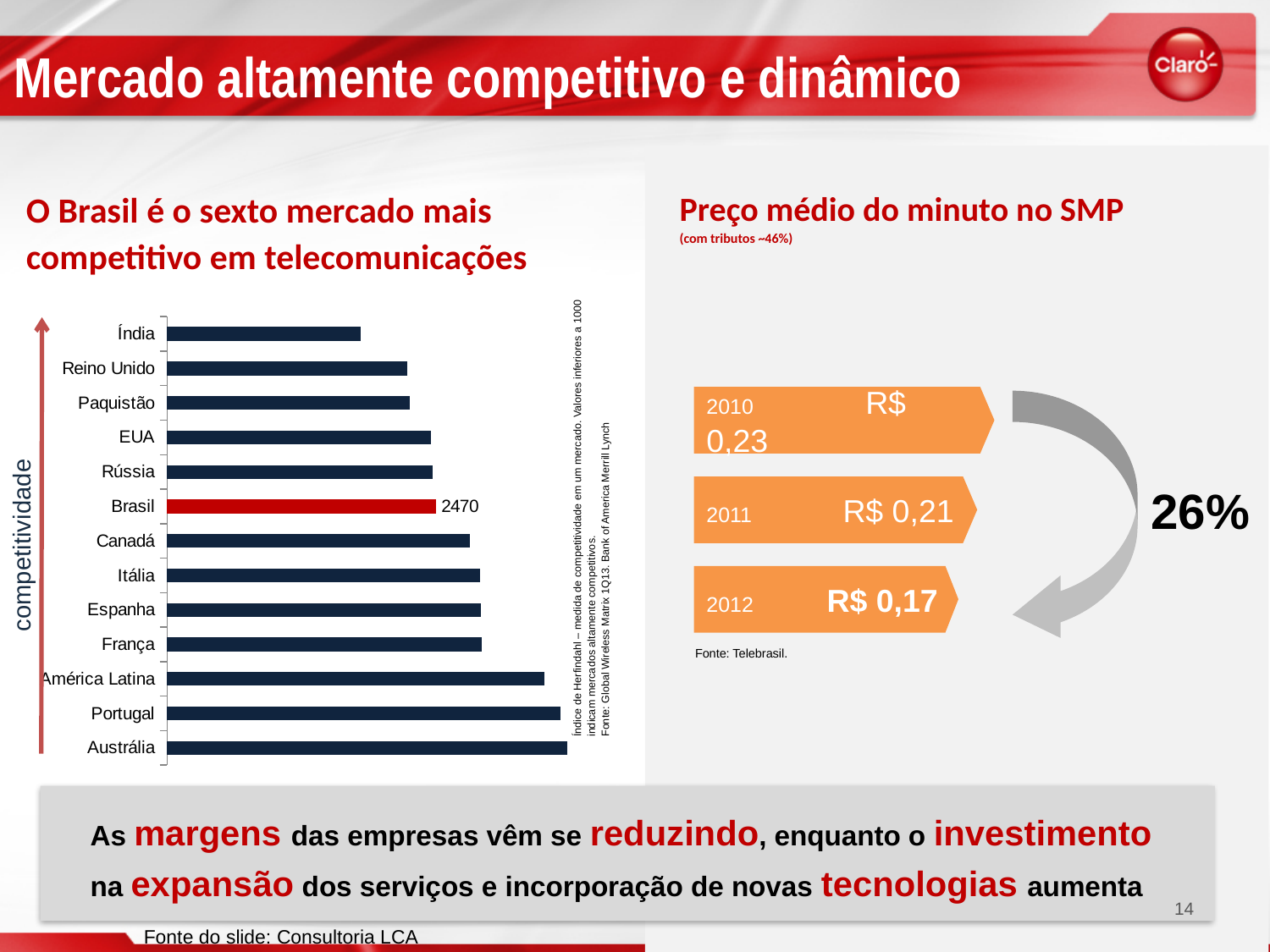
In the competitiveness bar chart, which has the longer bar, Brasil or Índia? Brasil What kind of chart is used to show the competitiveness of telecom markets on the left of the slide? bar chart Going from Índia at the top to Austrália at the bottom of the competitiveness bar chart, do the bars get longer or shorter? longer In the competitiveness bar chart, which has the longer bar, Reino Unido or Canadá? Canadá How many countries or regions are listed in the competitiveness bar chart? 13 In the competitiveness bar chart, which has the longer bar, Índia or Austrália? Austrália Which category's bar is coloured red in the competitiveness bar chart? Brasil Which category appears sixth from the top in the competitiveness bar chart? Brasil Which category has the shortest bar in the competitiveness bar chart? Índia What label is written along the vertical axis of the competitiveness bar chart? competitividade What value is labelled on the bar for Brasil in the competitiveness bar chart? 2470